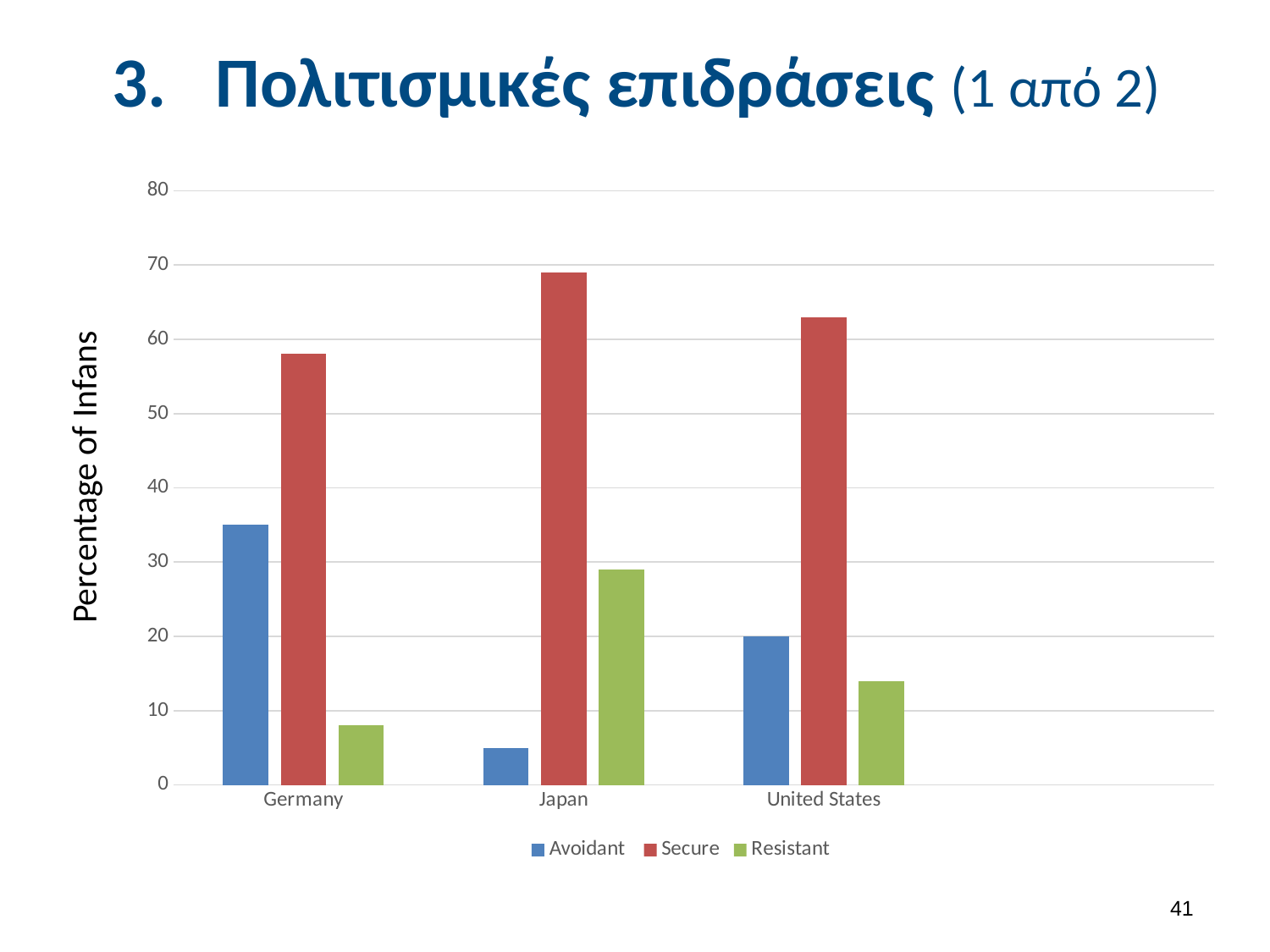
Is the Secure value for Japan greater or less than 60? greater Which country has the lowest Avoidant value? Japan Which is larger, the Avoidant value for Germany or the Avoidant value for the United States? Germany How many series does the chart's legend list? 3 How many countries are shown on the x axis of the chart? 3 Is the Resistant value for Germany greater or less than 10? less Which country has the highest Resistant value? Japan What kind of chart is shown on the slide? bar chart Is the Avoidant value for Germany greater or less than 30? greater Which series is shown in red in the chart? Secure Which country has the highest Secure value? Japan What is the label of the vertical axis of the chart? Percentage of Infans